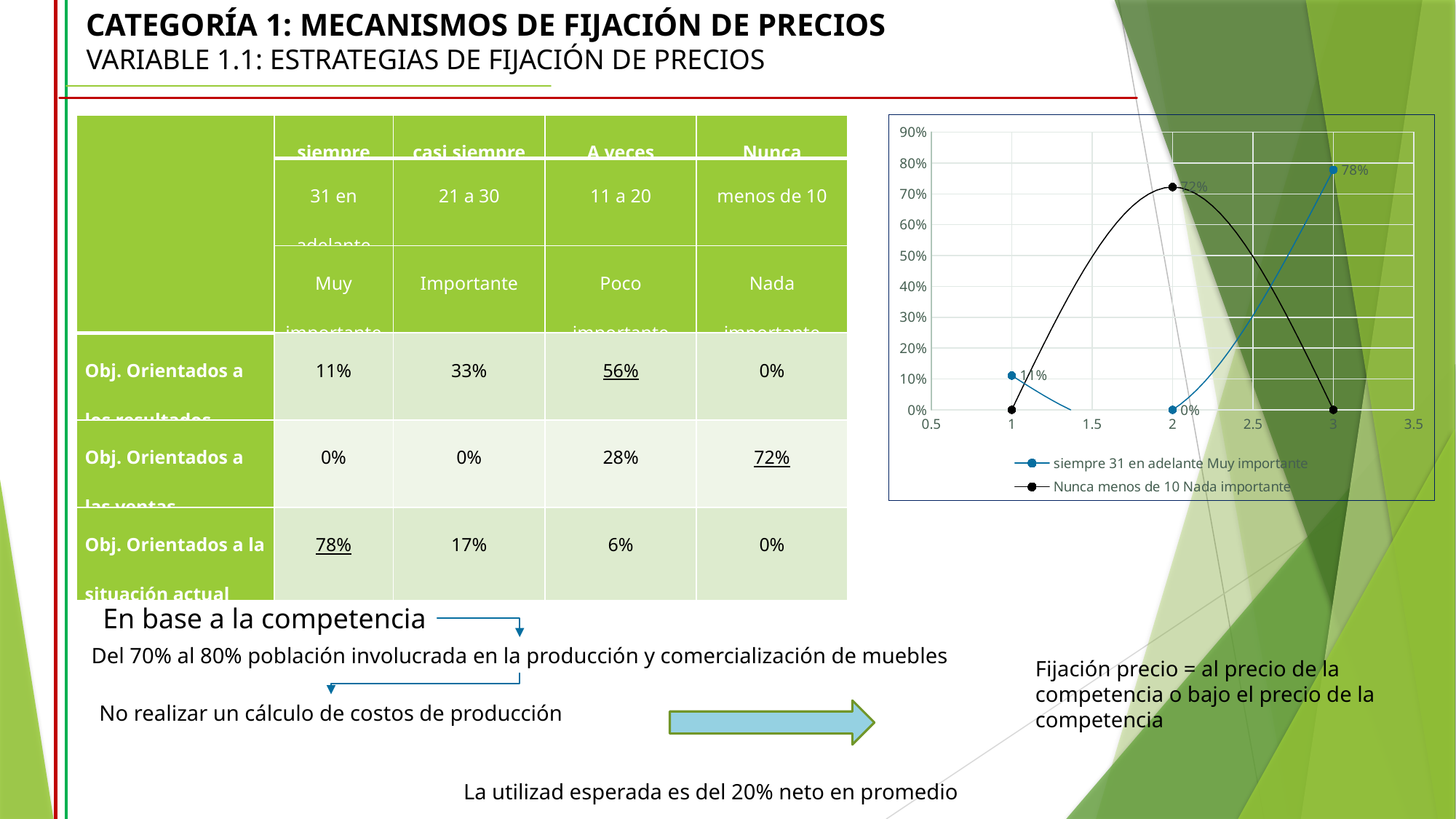
In the chart, is the value of the 'Nunca menos de 10 Nada importante' series at x = 2 greater or less than 50%? greater In the chart, what is the value of the 'Nunca menos de 10 Nada importante' series at x = 2? 72% How many series does the chart legend list? 2 In the chart, which series has the larger value at x = 2: 'siempre 31 en adelante Muy importante' or 'Nunca menos de 10 Nada importante'? Nunca menos de 10 Nada importante In the chart, what is the difference between the 'siempre 31 en adelante Muy importante' value at x = 3 and the 'Nunca menos de 10 Nada importante' value at x = 2? 6% What kind of chart is shown on the right of the slide? line chart What colour is the line for the 'Nunca menos de 10 Nada importante' series in the chart? black In the chart, what is the value of the 'siempre 31 en adelante Muy importante' series at x = 3? 78% In the chart, at which x value does the 'siempre 31 en adelante Muy importante' series reach its highest value? 3 In the chart, at which x value does the 'Nunca menos de 10 Nada importante' series reach its highest value? 2 In the chart, what is the value of the 'siempre 31 en adelante Muy importante' series at x = 2? 0% In the chart, what is the value of the 'siempre 31 en adelante Muy importante' series at x = 1? 11%